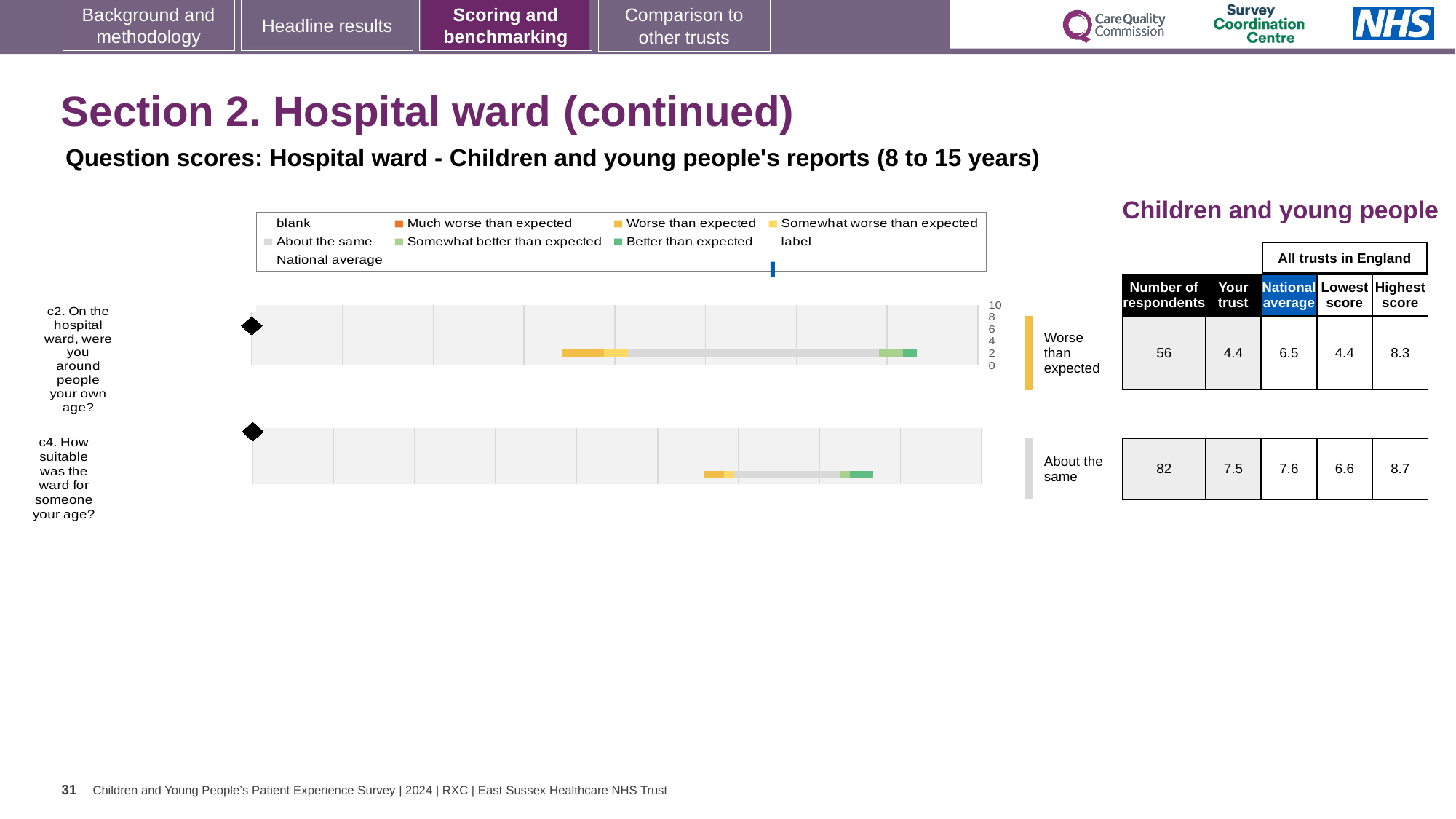
What is the difference between the highest and lowest scores for question c2? 3.9 Which question has the higher 'Your trust' score, c2 or c4? c4 What is the 'Your trust' score for question c2 (On the hospital ward, were you around people your own age?)? 4.4 What benchmark category is shown for question c2? Worse than expected What is the difference between the 'Your trust' scores for c4 and c2? 3.1 Is the 'Your trust' score for question c2 greater or less than 6? less What is the 'Your trust' score for question c4 (How suitable was the ward for someone your age?)? 7.5 What kind of chart is used to show the question scores on this slide? bar chart What is the national average score for question c2? 6.5 How many respondents answered question c4? 82 What is the highest score among all trusts in England for question c4? 8.7 How many questions are plotted in the chart? 2